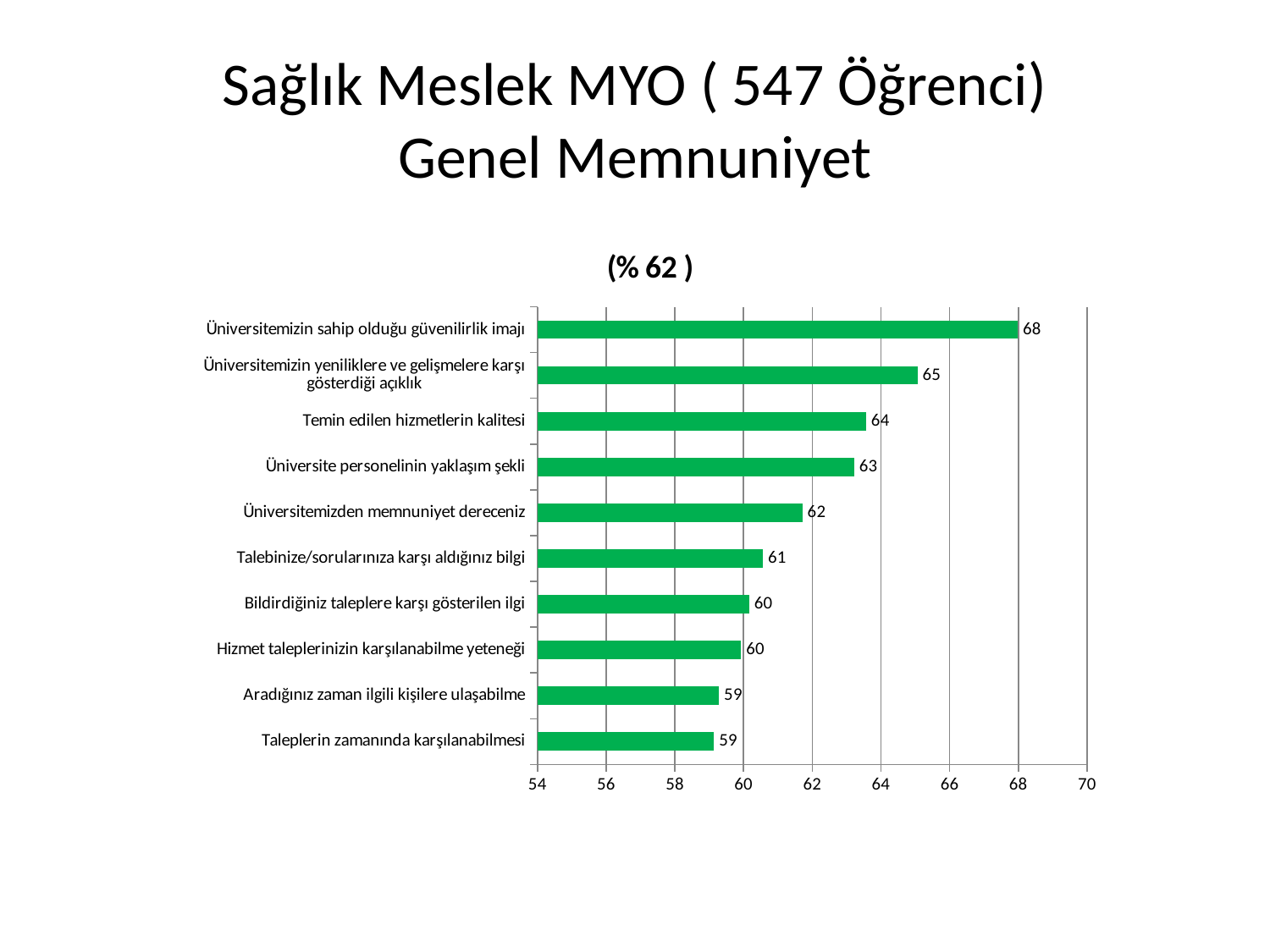
What kind of chart is shown on the slide? bar chart Is the value for "Üniversite personelinin yaklaşım şekli" greater or less than 62? greater What colour are the bars in the chart? green Which is larger: the value for "Üniversitemizin yeniliklere ve gelişmelere karşı gösterdiği açıklık" or the value for "Talebinize/sorularınıza karşı aldığınız bilgi"? Üniversitemizin yeniliklere ve gelişmelere karşı gösterdiği açıklık Which category has the highest value? Üniversitemizin sahip olduğu güvenilirlik imajı How many categories are shown in the chart? 10 What is the value for "Taleplerin zamanında karşılanabilmesi"? 59 What is the value for "Temin edilen hizmetlerin kalitesi"? 64 What is the value for "Üniversitemizden memnuniyet dereceniz"? 62 What is the difference between the values for "Üniversitemizin sahip olduğu güvenilirlik imajı" and "Üniversite personelinin yaklaşım şekli"? 5 What is the value for "Üniversitemizin sahip olduğu güvenilirlik imajı"? 68 What is the title of the chart? (% 62 )